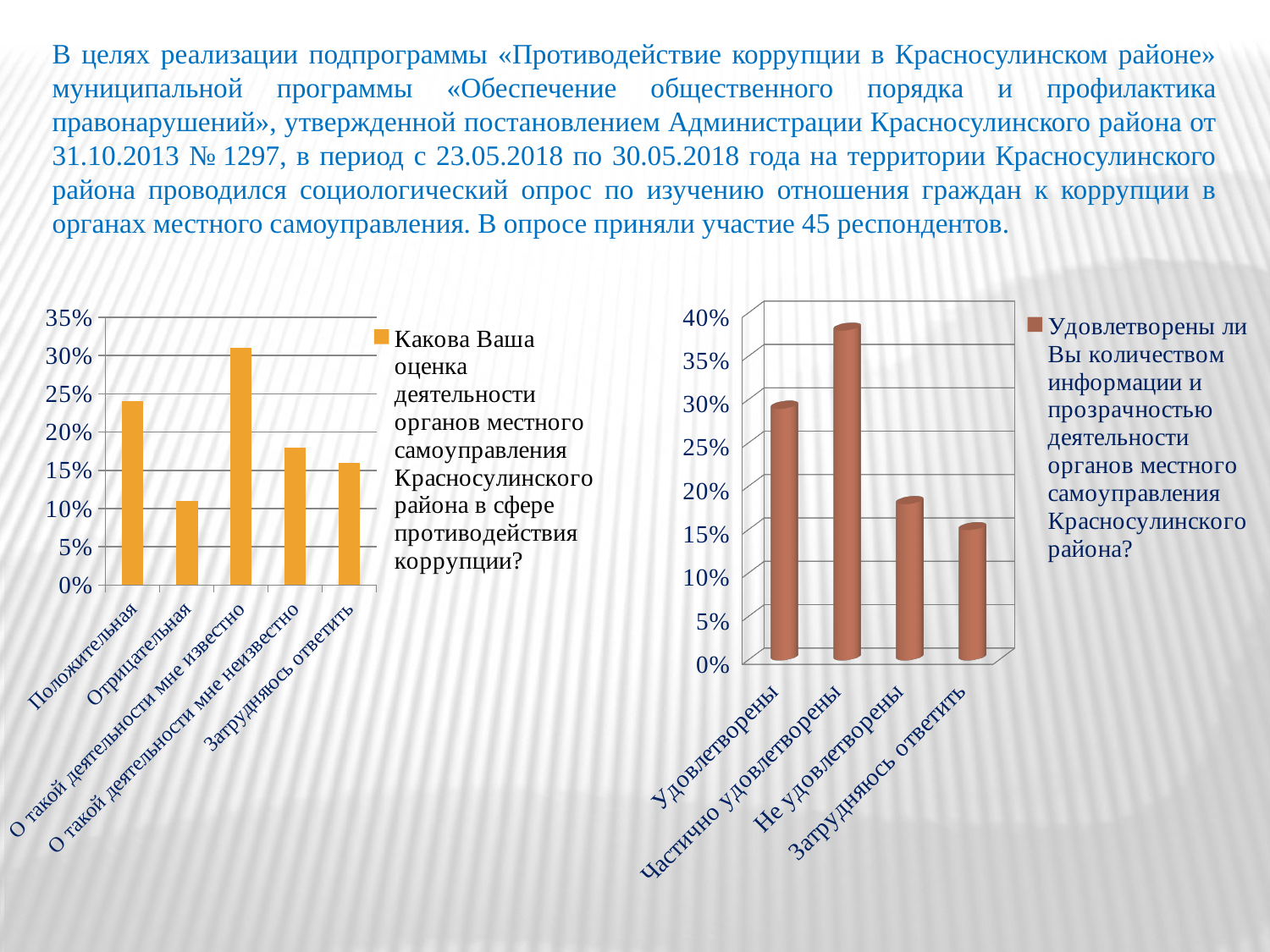
In the left chart, which is larger: Положительная or Затрудняюсь ответить? Положительная What kind of chart is the right chart? Bar chart In the left chart, which category has the lowest bar? Отрицательная How many categories does the right chart show? 4 In the left chart, is the value for Отрицательная greater or less than 15%? less In the right chart, which category has the highest bar? Частично удовлетворены How many categories does the left chart show? 5 In the right chart, is the value for Удовлетворены greater or less than 25%? greater In the left chart, is the value for Положительная greater or less than 20%? greater In the left chart, which category has the highest bar? О такой деятельности мне известно In the right chart, which category has the lowest bar? Затрудняюсь ответить